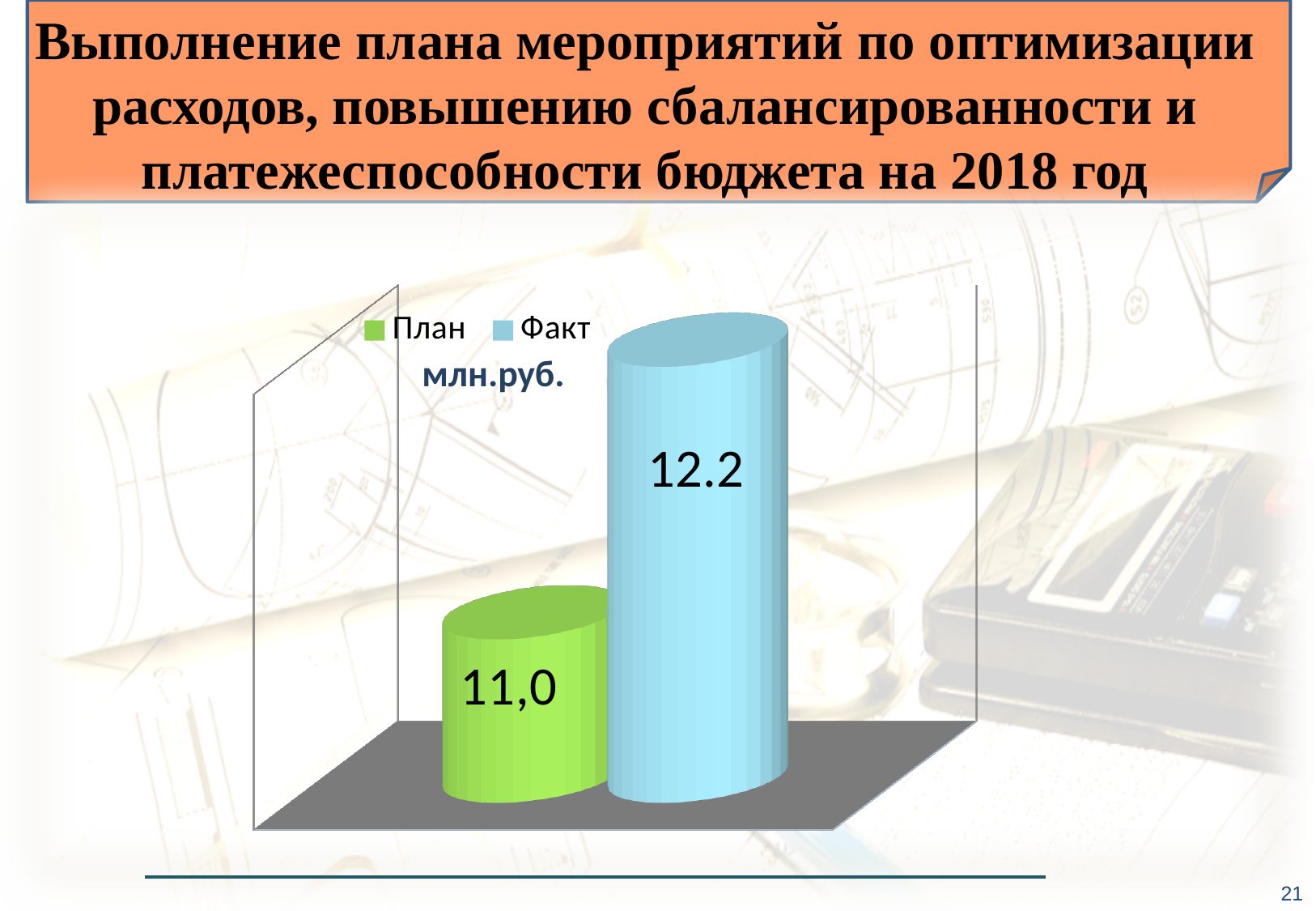
What kind of chart is shown on the slide? Bar chart Which series shows the highest value on the chart? Факт By how much does the Факт value exceed the План value? 1.2 What colour is the bar for Факт? Blue How many series does the legend list? 2 Which series shows the lowest value on the chart? План What unit of measurement is indicated on the chart? млн.руб. What is the value for План (plan) on the chart? 11,0 Which series has the higher value, План or Факт? Факт What is the value for Факт (actual) on the chart? 12.2 How many bars are plotted on the chart? 2